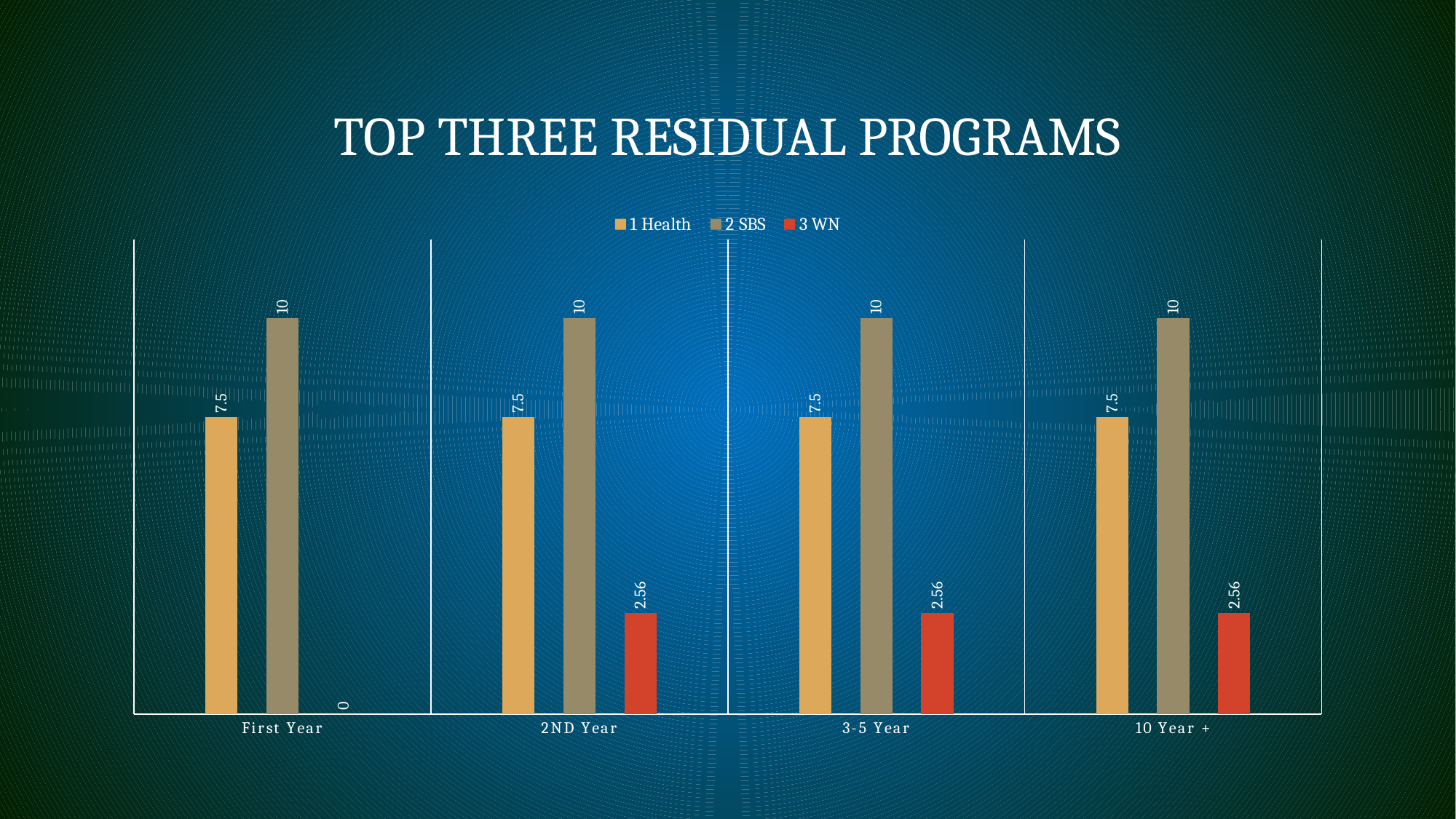
What is the difference between the 1 Health and 3 WN values in the 3-5 Year category? 4.94 How many series does the legend list? 3 Which series has the highest value in the 3-5 Year category? 2 SBS What is the value for 1 Health in the First Year category? 7.5 What is the difference between the 2 SBS and 1 Health values in the 2ND Year category? 2.5 What is the value for 3 WN in the 2ND Year category? 2.56 How many categories are shown on the x axis? 4 What is the value for 3 WN in the First Year category? 0 What kind of chart is shown on the slide? Bar chart Which is larger in the First Year category, 1 Health or 2 SBS? 2 SBS What is the value for 2 SBS in the 10 Year + category? 10 Which series has the lowest value in the 10 Year + category? 3 WN